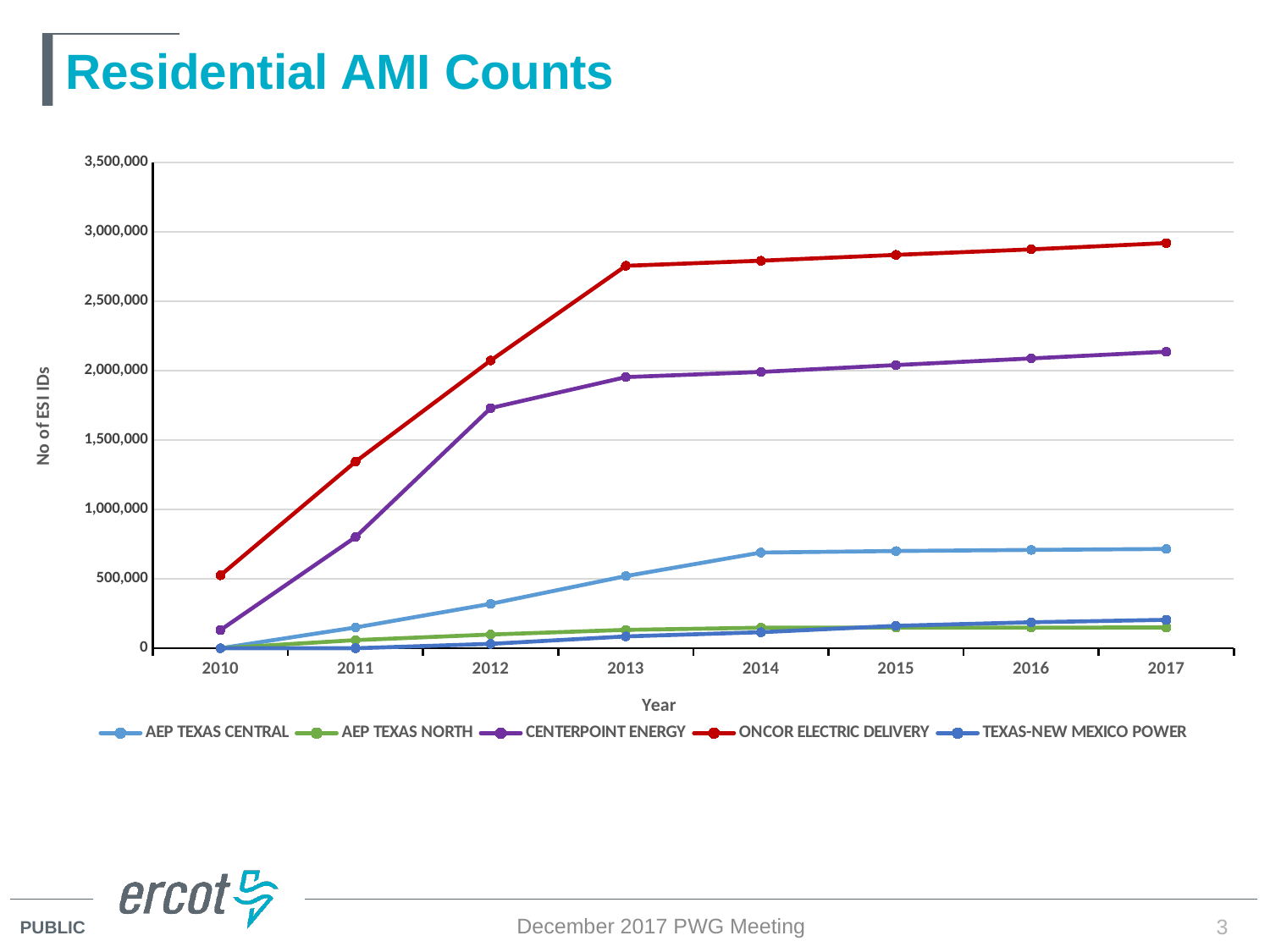
What is the label on the vertical axis? No of ESI IDs What kind of chart is shown on the slide? line chart Is the value for CENTERPOINT ENERGY in 2011 greater or less than 1,000,000? less Is the value for AEP TEXAS CENTRAL in 2017 greater or less than 1,000,000? less Is the value for ONCOR ELECTRIC DELIVERY in 2017 greater or less than 2,500,000? greater How many years are plotted along the x axis? 8 Which series has the highest value in 2017? ONCOR ELECTRIC DELIVERY Do the values for ONCOR ELECTRIC DELIVERY rise or fall from 2010 to 2017? rise In 2014, which is larger: ONCOR ELECTRIC DELIVERY or CENTERPOINT ENERGY? ONCOR ELECTRIC DELIVERY How many series does the legend list? 5 In 2016, which is larger: AEP TEXAS CENTRAL or AEP TEXAS NORTH? AEP TEXAS CENTRAL